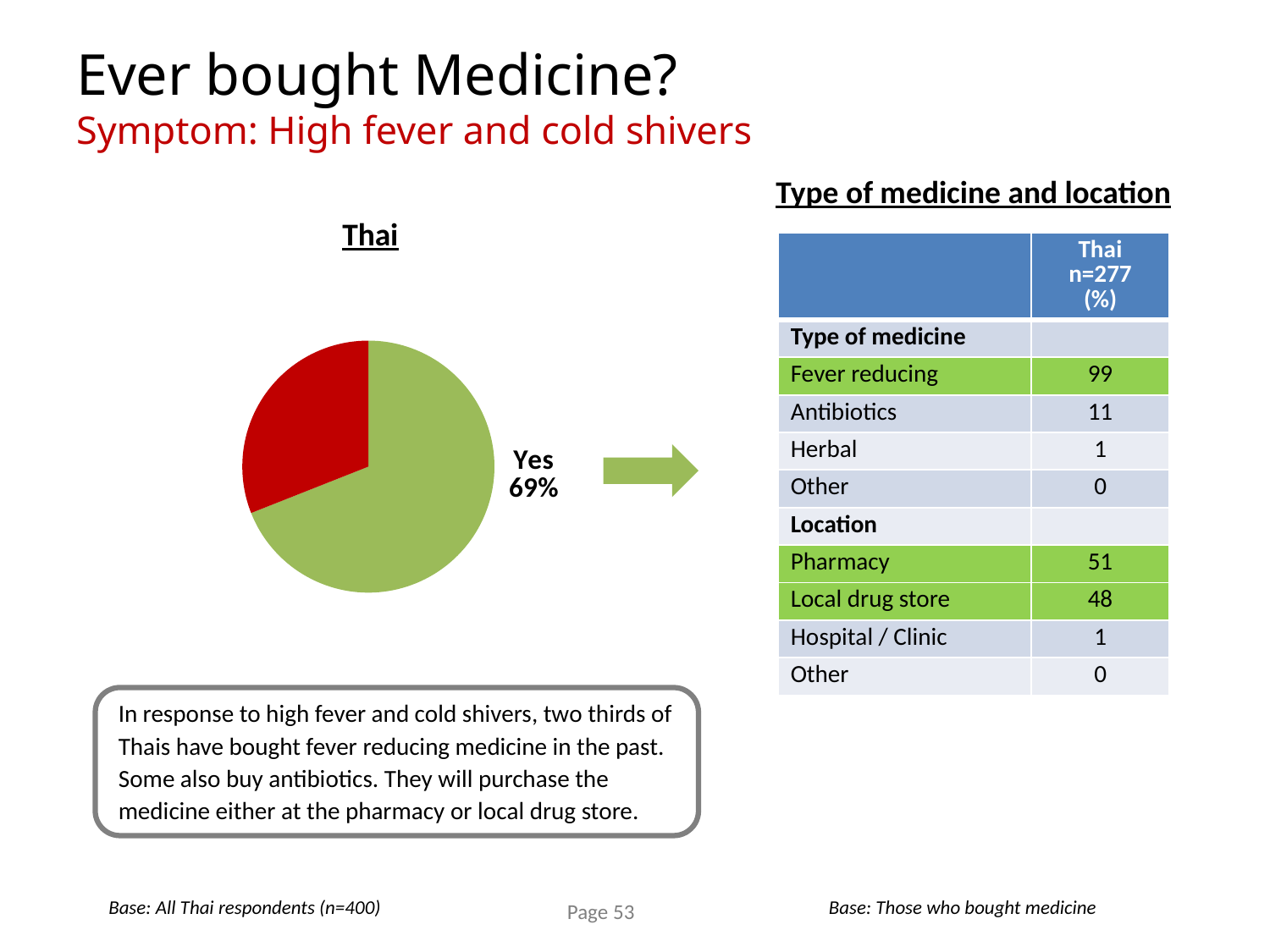
Which slice of the pie chart is larger, the green slice or the red slice? the green slice How many slices does the pie chart have? 2 What kind of chart is shown on the slide? pie chart What is the title of the pie chart? Thai What colour is the "Yes" slice in the pie chart? green What share of the pie chart is labelled "Yes"? 69% Is the share of the "Yes" slice in the pie chart greater or less than 50%? greater Which slice of the pie chart is the largest? Yes